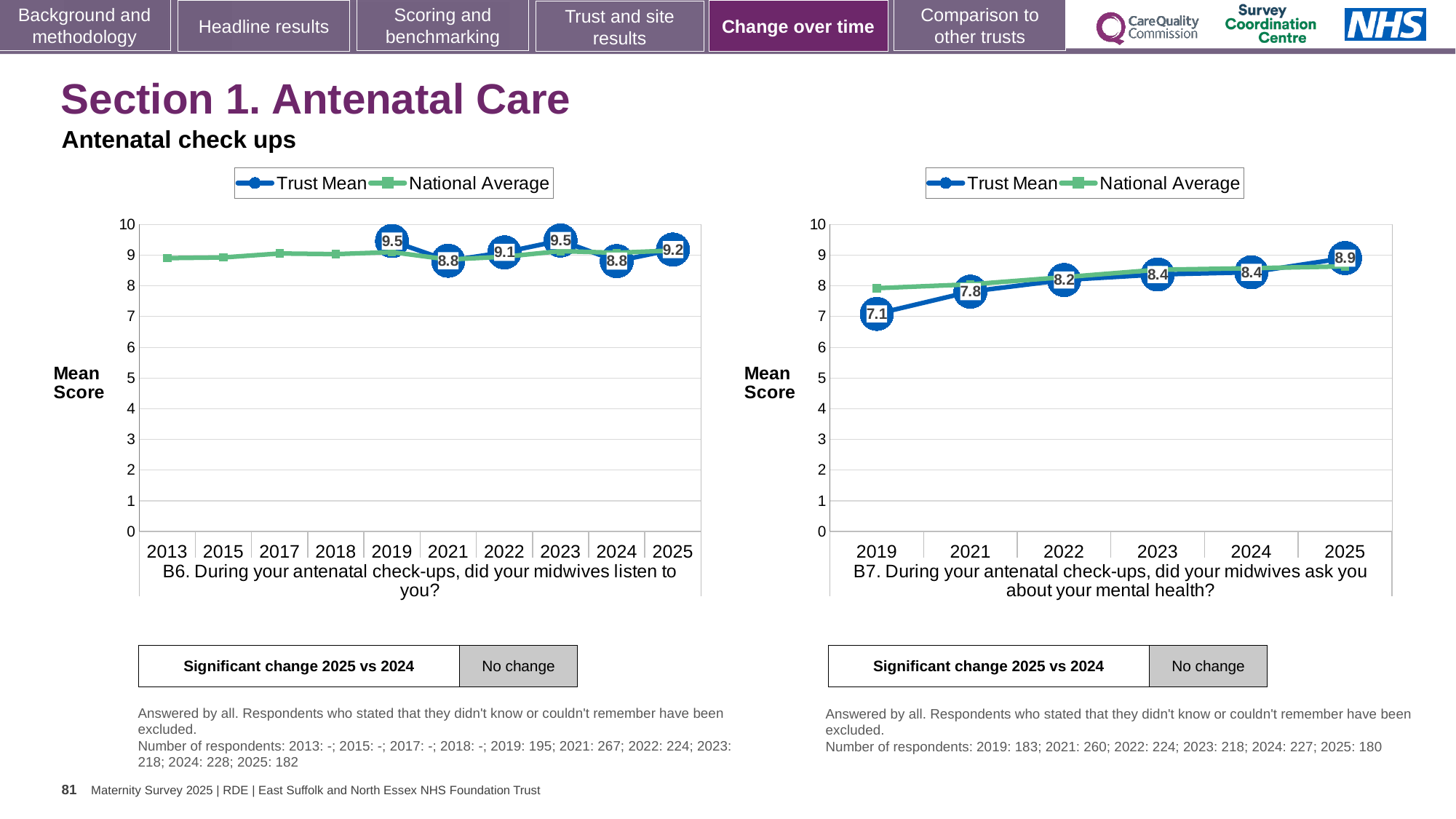
How many series does the legend of the B7 chart (right) list? 2 In the B6 chart (left), what is the Trust Mean for 2025? 9.2 In the B7 chart (right), what is the Trust Mean for 2025? 8.9 In the B7 chart (right), what is the difference between the Trust Mean for 2025 and the Trust Mean for 2019? 1.8 In the B7 chart (right), does the Trust Mean generally rise or fall from 2019 to 2025? rise In the B7 chart (right), which year has the highest Trust Mean? 2025 In the B6 chart (left), is the Trust Mean for 2022 larger or smaller than the Trust Mean for 2021? larger How many years are shown on the x axis of the B6 chart (left)? 10 In the B7 chart (right), which year has the lowest Trust Mean? 2019 In the B6 chart (left), what is the Trust Mean for 2021? 8.8 In the B6 chart (left), what is the difference between the Trust Mean for 2023 and the Trust Mean for 2024? 0.7 In the B7 chart (right), what is the Trust Mean for 2019? 7.1